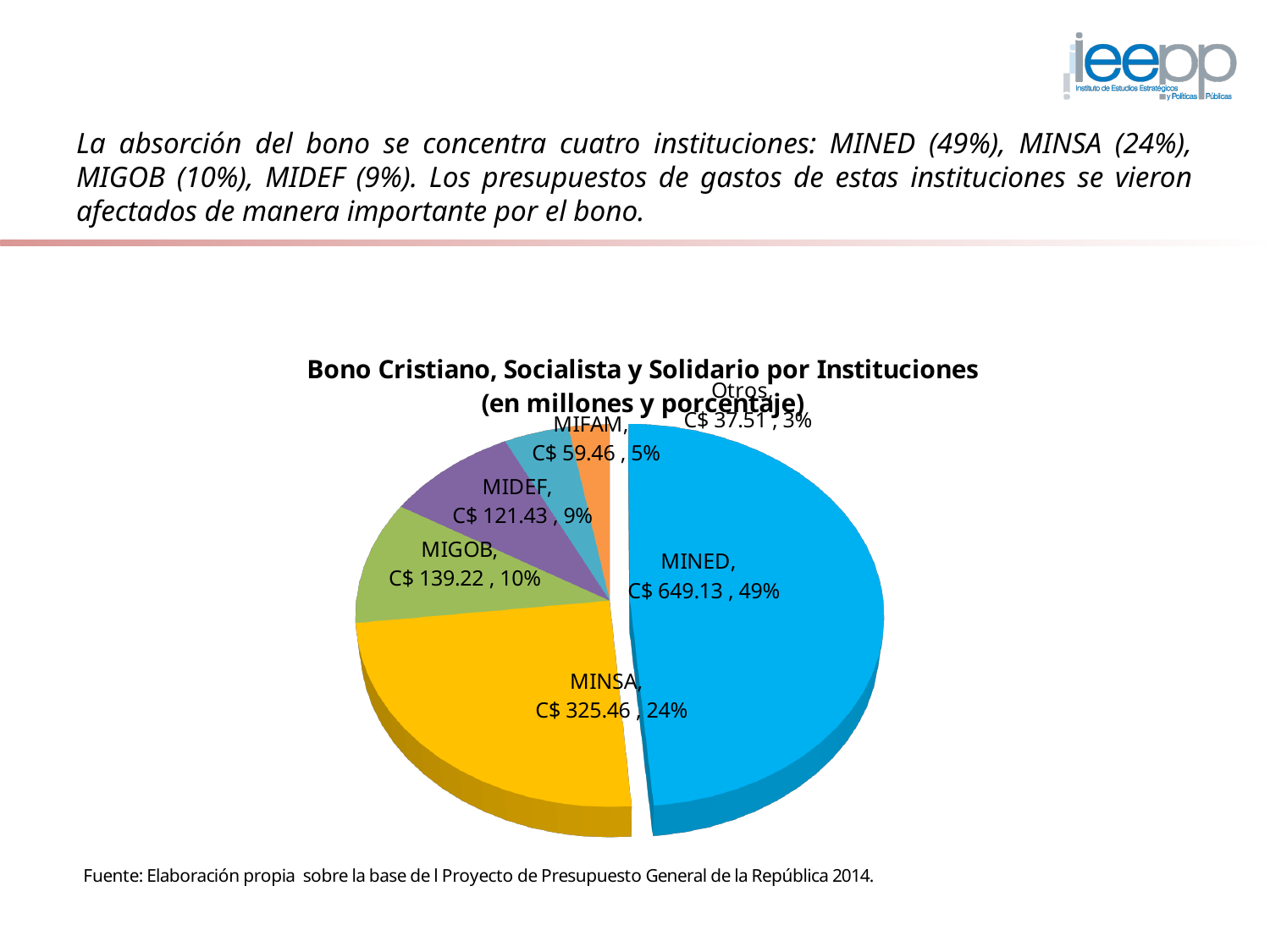
Which category has the smallest slice of the pie? Otros How many slices does the pie chart have? 6 What share of the pie does Otros represent? 3% What share of the pie does MINED represent? 49% What is the value for MIDEF in the pie chart? C$ 121.43 What is the value for MINSA in the pie chart? C$ 325.46 What is the value for MIGOB in the pie chart? C$ 139.22 What is the difference between the values for MINED and MINSA? C$ 323.67 Which is larger, the value for MIGOB or the value for MIDEF? MIGOB What is the value for MIFAM in the pie chart? C$ 59.46 What is the value for MINED in the pie chart? C$ 649.13 Which institution has the largest slice of the pie? MINED